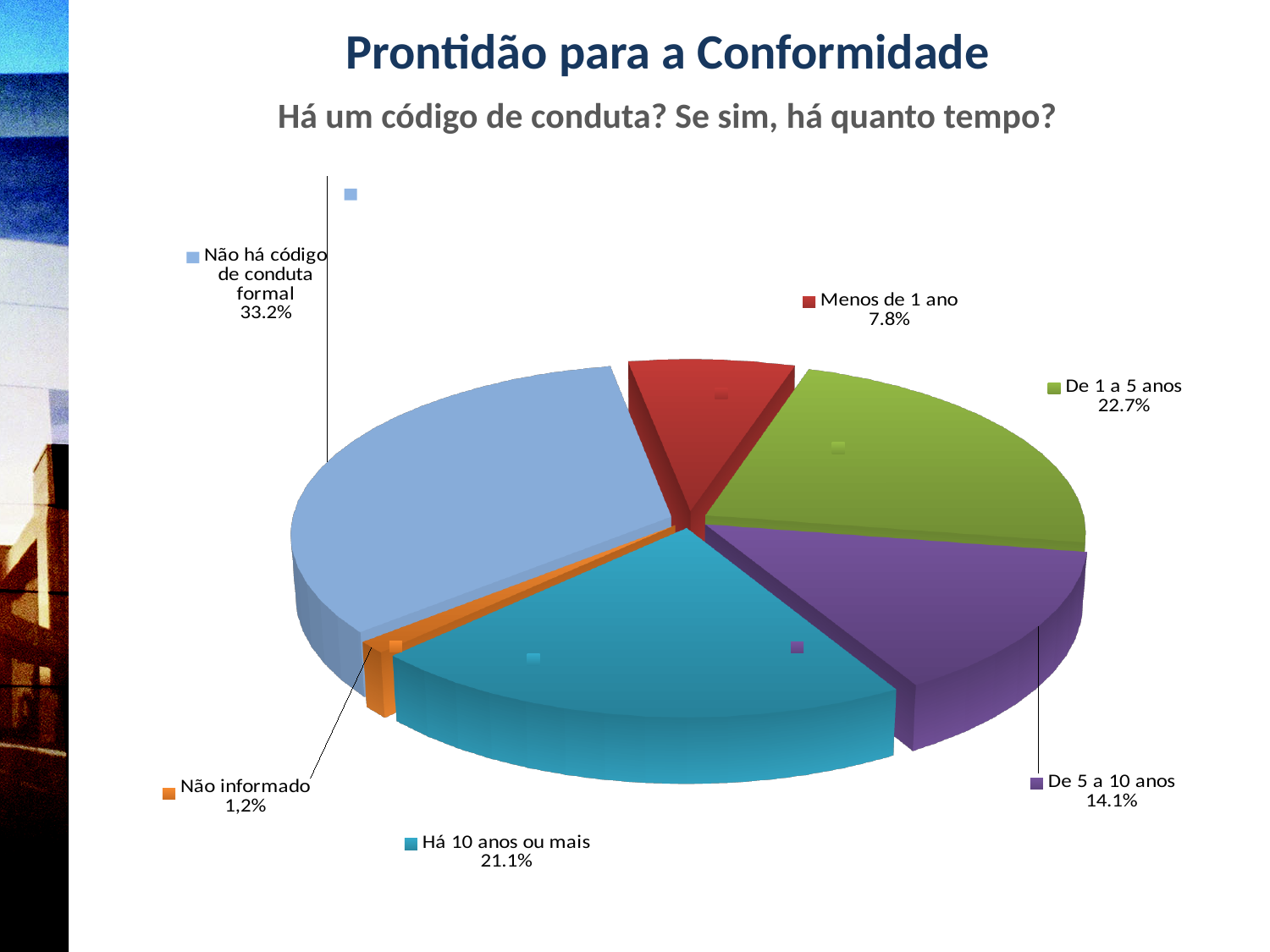
Which is larger, "De 1 a 5 anos" or "De 5 a 10 anos"? De 1 a 5 anos What is the value for "Menos de 1 ano"? 7.8% What is the value for "Há 10 anos ou mais"? 21.1% What is the value for "Não informado"? 1,2% What is the value for "De 5 a 10 anos"? 14.1% Which category has the smallest share of the pie? Não informado What kind of chart is shown on the slide? Pie chart What is the difference between "De 1 a 5 anos" and "Há 10 anos ou mais"? 1.6% How many slices does the pie chart have? 6 What is the value for "Não há código de conduta formal"? 33.2% Which category has the largest share of the pie? Não há código de conduta formal What is the value for "De 1 a 5 anos"? 22.7%